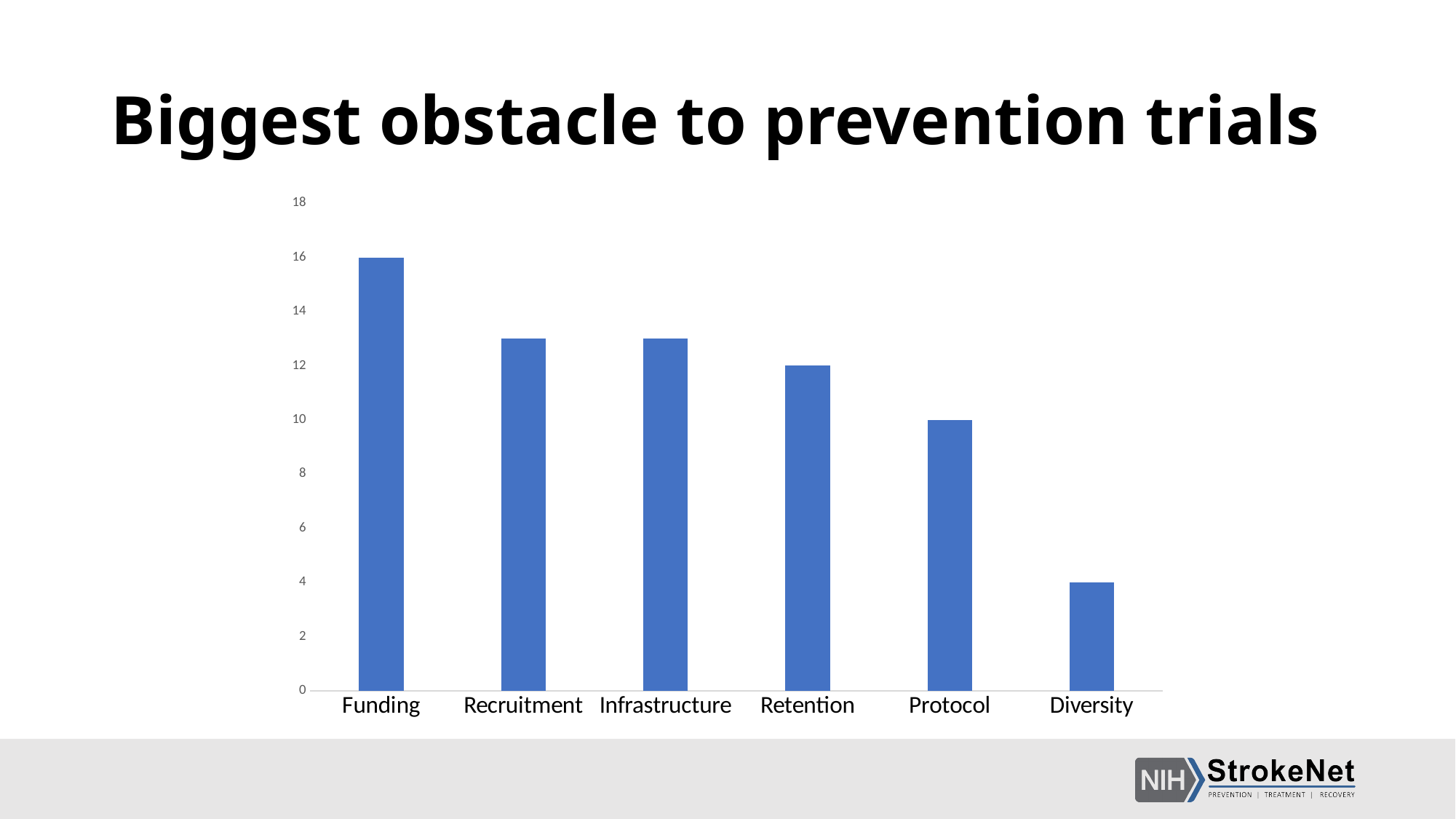
What is the value for Retention? 12 Which category has the lowest value? Diversity What is the value for Diversity? 4 What is the difference between the value for Funding and the value for Diversity? 12 What kind of chart is shown on the slide? bar chart Is the value for Recruitment greater or less than 12? greater How many categories are shown on the x axis? 6 Which category has the highest value? Funding What is the value for Funding? 16 Which is larger, the value for Funding or the value for Protocol? Funding What is the title of the chart? Biggest obstacle to prevention trials What is the value for Protocol? 10